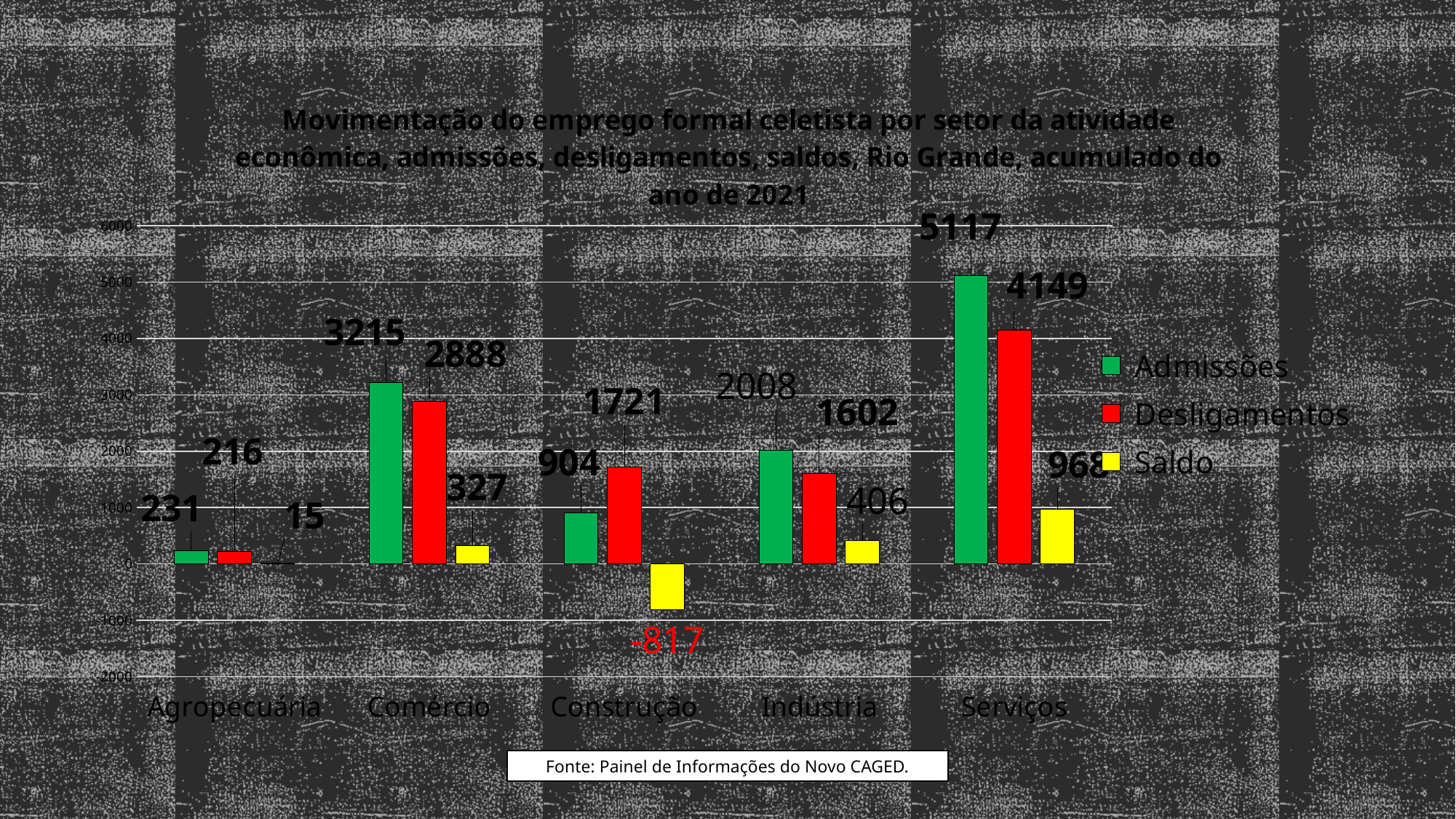
What kind of chart is shown on the slide? Bar chart Which colour represents the Saldo series in the legend? Yellow Which sector has the lowest Saldo value? Construção What is the value of Admissões for Serviços? 5117 How many series does the legend list? 3 How many sectors are shown on the x axis? 5 Which is larger for Construção, Admissões or Desligamentos? Desligamentos What is the difference between Admissões and Desligamentos for Comércio? 327 What is the value of Desligamentos for Comércio? 2888 Which sector has the highest Admissões value? Serviços What is the Saldo value for Construção? -817 What is the value of Admissões for Indústria? 2008